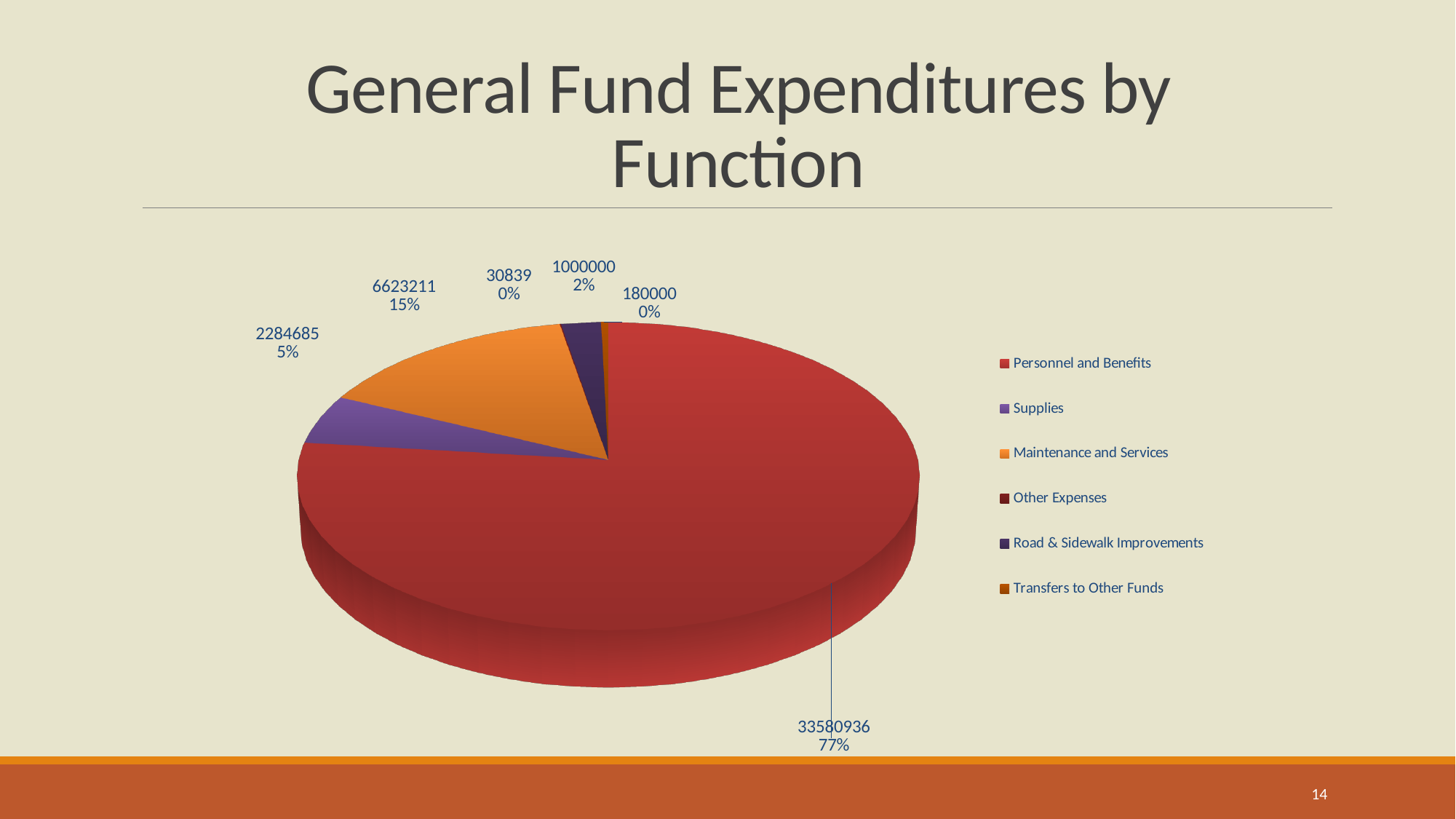
What is the difference between the values for Maintenance and Services and Supplies? 4338526 What is the value for Road & Sidewalk Improvements? 1000000 What share of the pie does Maintenance and Services represent? 15% What share of the pie does Personnel and Benefits represent? 77% What is the value for Maintenance and Services? 6623211 Which category has the largest share of the pie? Personnel and Benefits What type of chart is shown on the slide? Pie chart What is the value for Personnel and Benefits? 33580936 How many categories does the legend list? 6 What is the value for Supplies? 2284685 Which is larger, the value for Supplies or the value for Road & Sidewalk Improvements? Supplies Which category has the smallest value? Other Expenses